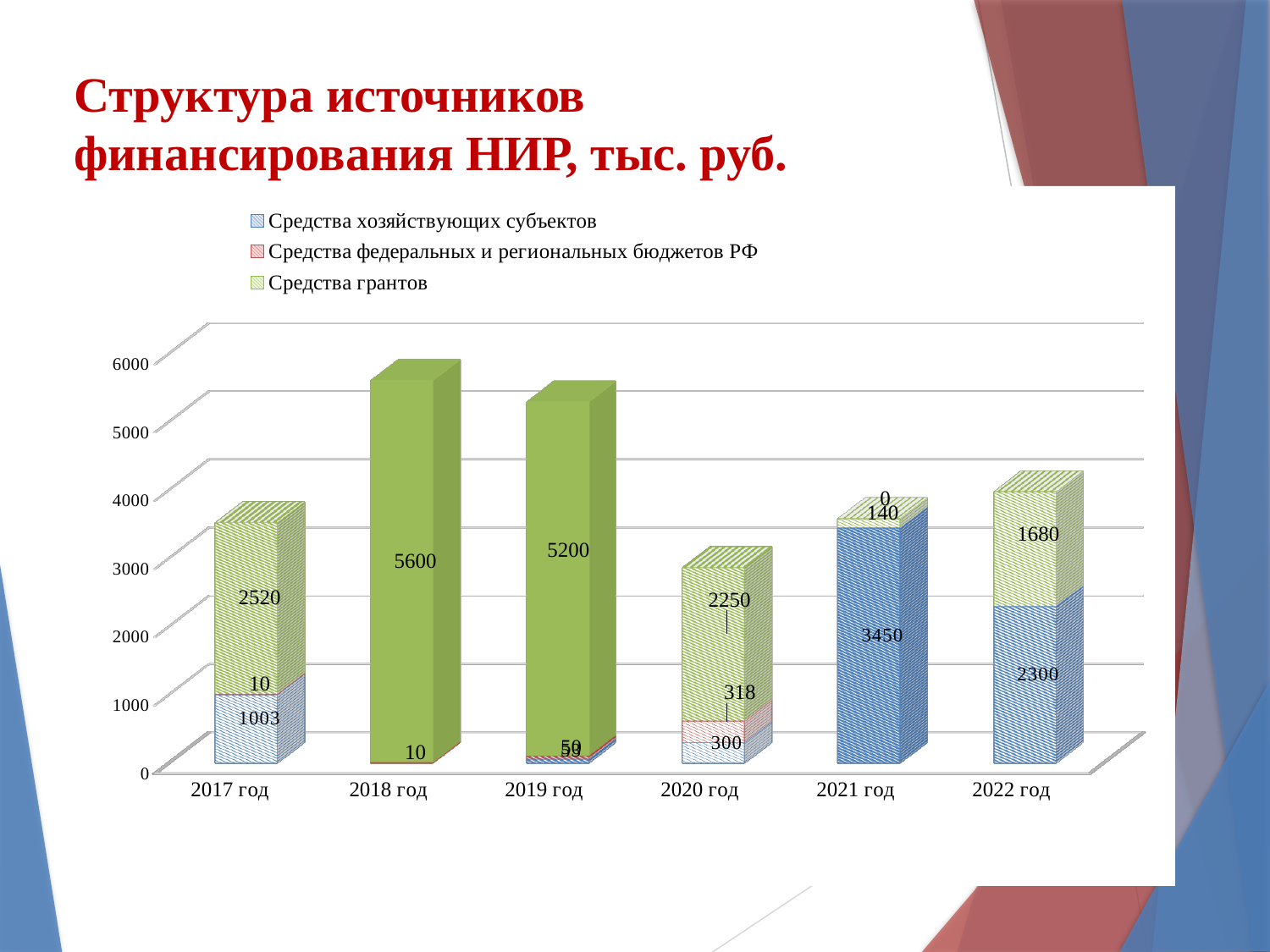
What is the title of the chart? Структура источников финансирования НИР, тыс. руб. Which year has the larger value of Средства хозяйствующих субъектов, 2017 год or 2022 год? 2022 год What is the total of the stacked bar for 2017 год? 3533 In which year is Средства грантов the highest? 2018 год What is the value of Средства грантов for 2018 год? 5600 How many years are shown on the x axis? 6 What kind of chart is shown on the slide? bar chart What is the value of Средства хозяйствующих субъектов for 2021 год? 3450 How many series does the legend list? 3 What is the difference between Средства грантов in 2018 год and 2019 год? 400 What is the value of Средства грантов for 2017 год? 2520 What is the value of Средства федеральных и региональных бюджетов РФ for 2020 год? 318